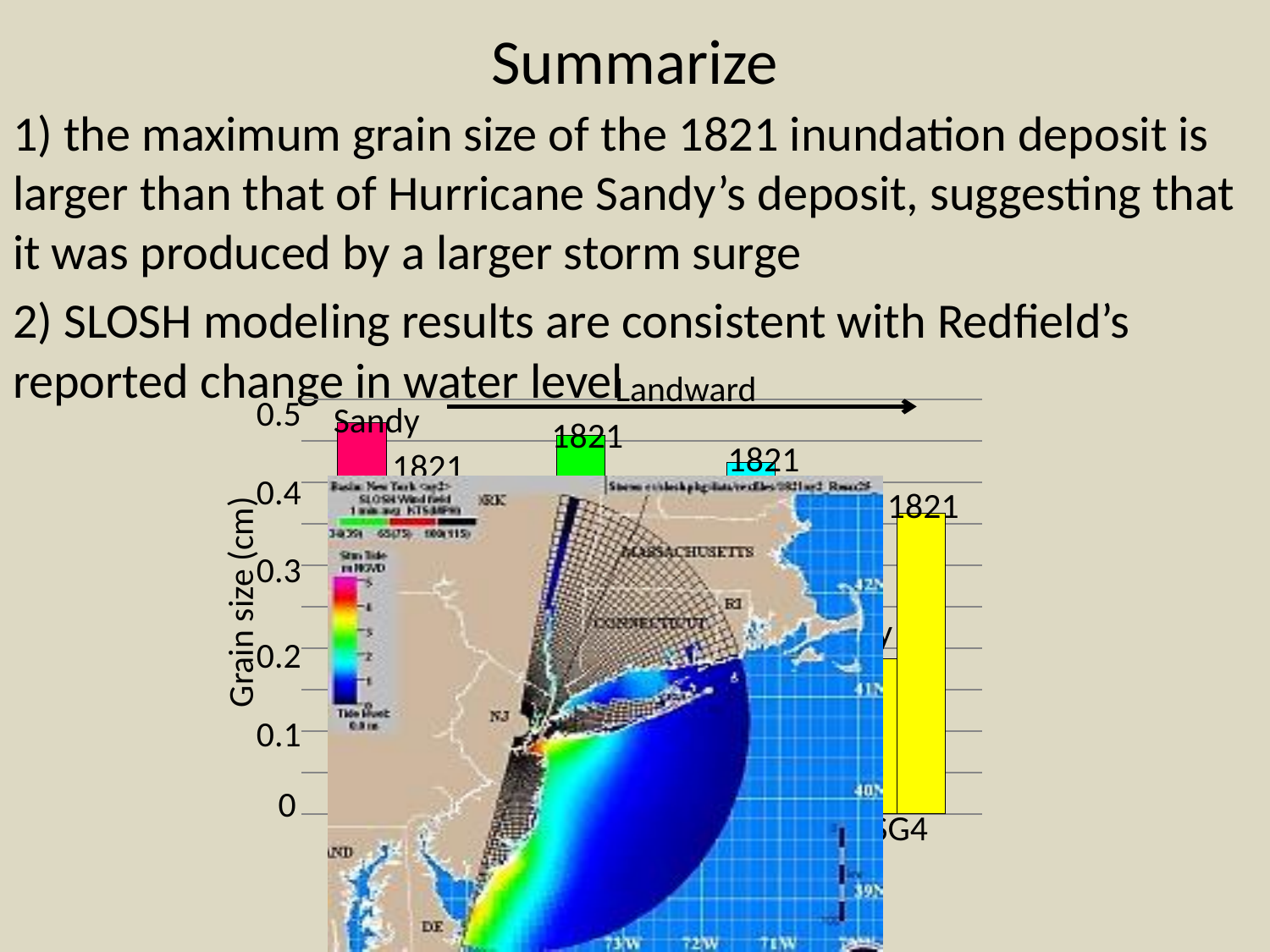
Is the value of the cyan bar labeled 1821 greater or less than 0.3? greater Is the value of the yellow bar labeled 1821 on the right greater or less than 0.3? greater Which is larger, the green 1821 bar or the yellow 1821 bar on the right? the green 1821 bar Which is larger, the pink Sandy bar or the yellow 1821 bar on the right? the pink Sandy bar What is the label on the vertical axis of the chart? Grain size (cm) Is the value of the pink bar labeled Sandy greater or less than 0.4? greater What kind of chart is shown on the slide? bar chart What is the highest tick value shown on the vertical axis of the chart? 0.5